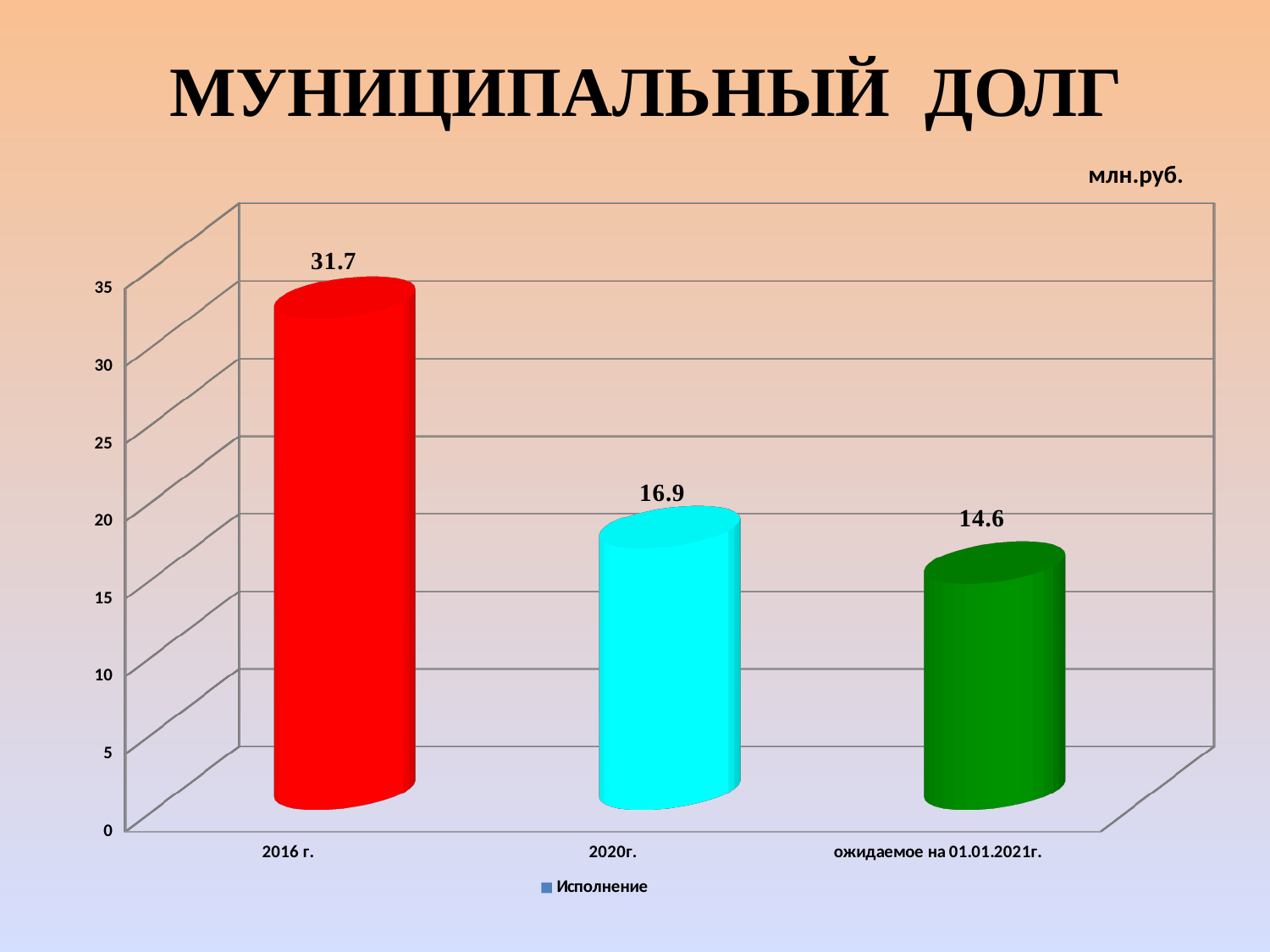
Which category has the highest value? 2016 г. What is the value for 2016 г.? 31.7 What is the difference between the values for 2016 г. and 2020г.? 14.8 Which category has the lowest value? ожидаемое на 01.01.2021г. Which is larger, the value for 2020г. or the value for ожидаемое на 01.01.2021г.? 2020г. What is the value for ожидаемое на 01.01.2021г.? 14.6 Is the value for 2016 г. greater or less than 30? greater What is the difference between the values for 2020г. and ожидаемое на 01.01.2021г.? 2.3 What kind of chart is shown on the slide? bar chart What is the value for 2020г.? 16.9 How many categories are shown on the x axis? 3 Do the values rise or fall from left to right along the x axis? fall